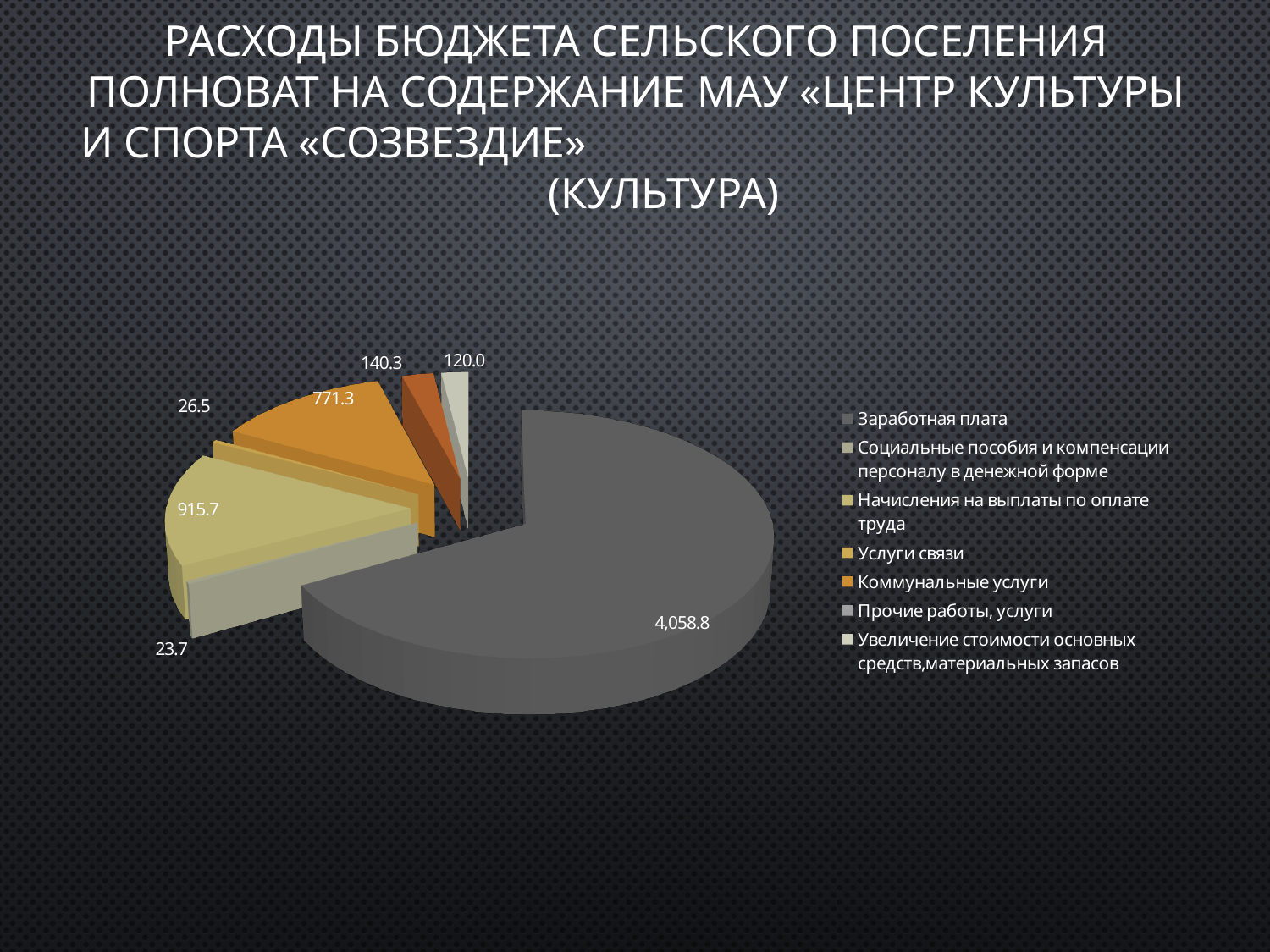
What is the value for Коммунальные услуги? 771.3 Which category has the smallest value? Социальные пособия и компенсации персоналу в денежной форме Which category has the largest slice of the pie? Заработная плата What is the value for Начисления на выплаты по оплате труда? 915.7 What is the difference between Начисления на выплаты по оплате труда and Коммунальные услуги? 144.4 What type of chart is shown on the slide? pie chart What is the value for Заработная плата? 4,058.8 What is the value for Увеличение стоимости основных средств, материальных запасов? 120.0 What colour is the slice for Заработная плата? gray How many categories does the pie chart have? 7